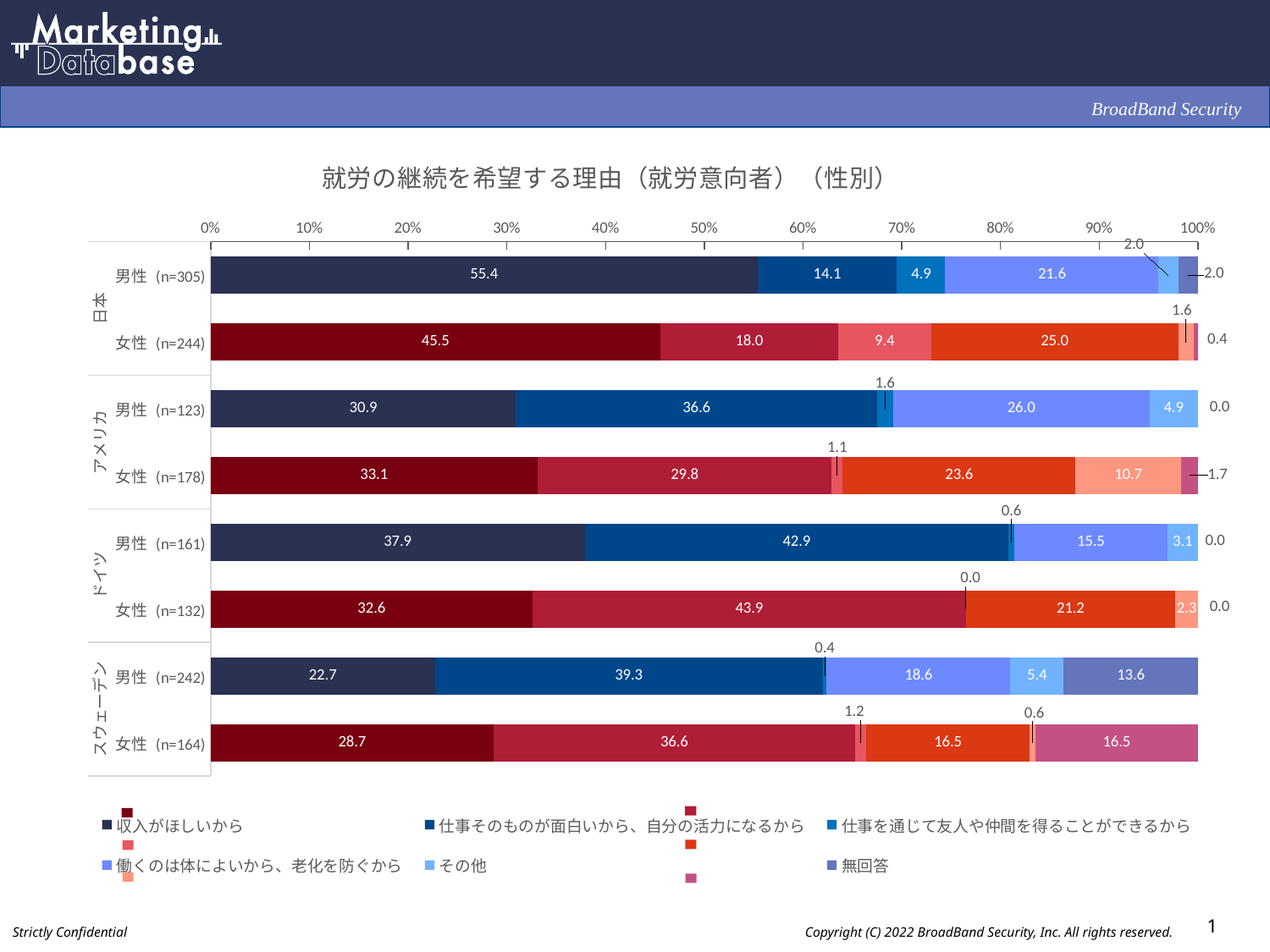
What is the value of 働くのは体によいから、老化を防ぐから for アメリカ 男性 (n=123)? 26.0 What is the difference between the 収入がほしいから values for 日本 男性 (n=305) and 日本 女性 (n=244)? 9.9 How many bars (groups) are shown in the chart? 8 Which is larger: the 仕事そのものが面白いから、自分の活力になるから value for アメリカ 男性 (n=123) or for アメリカ 女性 (n=178)? アメリカ 男性 (n=123) What is the value of 仕事そのものが面白いから、自分の活力になるから for ドイツ 女性 (n=132)? 43.9 Which group has the lowest value for 収入がほしいから? スウェーデン 男性 (n=242) What is the value of 収入がほしいから for 日本 男性 (n=305)? 55.4 What is the title of the chart? 就労の継続を希望する理由（就労意向者）（性別） Which group has the highest value for 収入がほしいから? 日本 男性 (n=305) How many series does the legend list? 6 What type of chart is shown on the slide? Stacked bar chart What is the value of 無回答 for スウェーデン 男性 (n=242)? 13.6